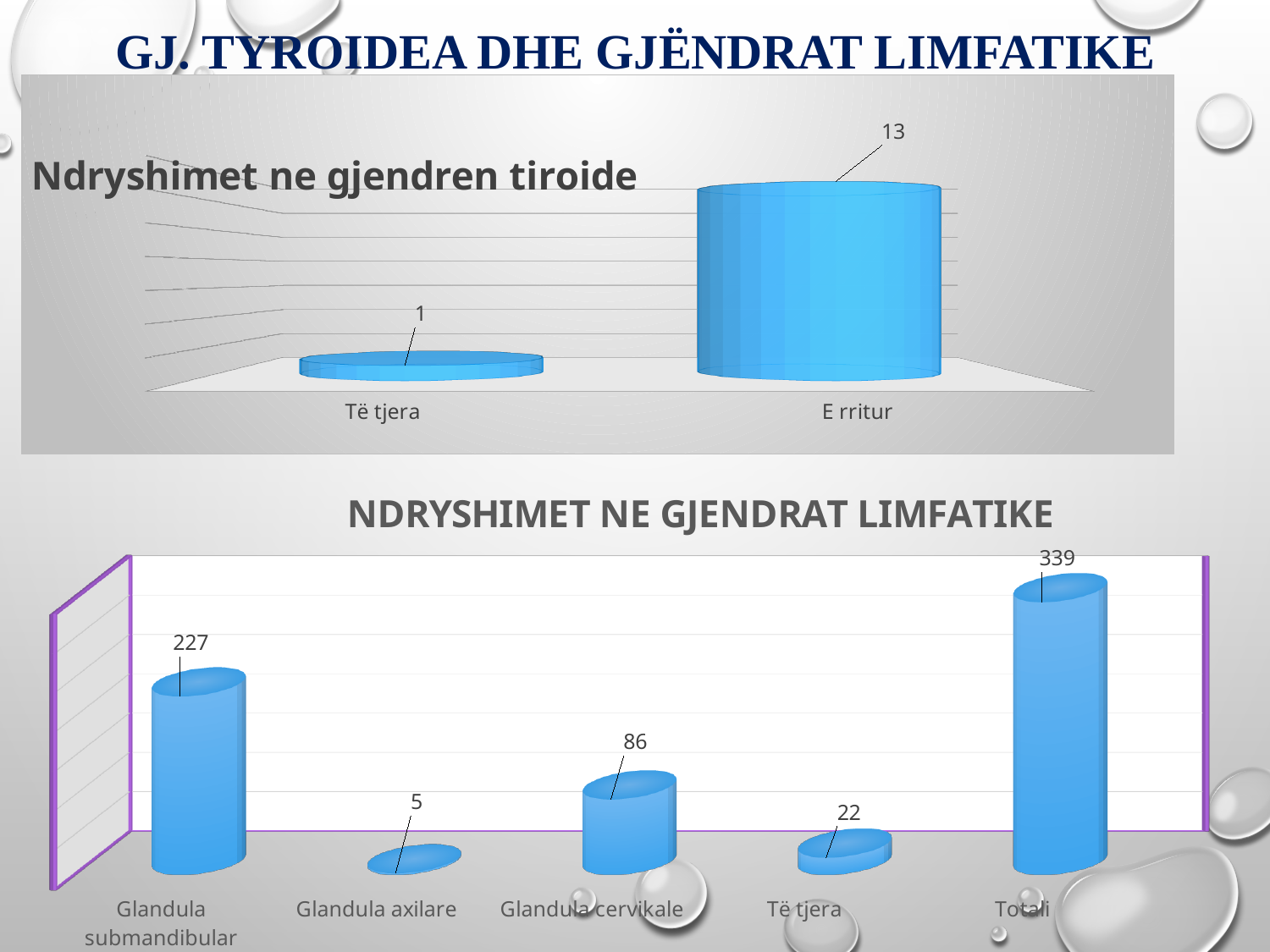
In the chart titled 'Ndryshimet ne gjendrat limfatike', what is the value for 'Glandula cervikale'? 86 In the chart titled 'Ndryshimet ne gjendrat limfatike', what is the value for 'Glandula submandibular'? 227 In the chart titled 'Ndryshimet ne gjendrat limfatike', which category has the highest value? Totali What kind of chart is the chart titled 'Ndryshimet ne gjendrat limfatike'? Bar chart In the chart titled 'Ndryshimet ne gjendrat limfatike', what is the value for 'Të tjera'? 22 In the chart titled 'Ndryshimet ne gjendren tiroide', what is the difference between 'E rritur' and 'Të tjera'? 12 In the chart titled 'Ndryshimet ne gjendren tiroide', what is the value for 'E rritur'? 13 In the chart titled 'Ndryshimet ne gjendren tiroide', what is the value for 'Të tjera'? 1 In the chart titled 'Ndryshimet ne gjendren tiroide', how many categories are shown? 2 In the chart titled 'Ndryshimet ne gjendrat limfatike', what is the difference between 'Glandula submandibular' and 'Glandula cervikale'? 141 In the chart titled 'Ndryshimet ne gjendrat limfatike', which is larger: 'Glandula cervikale' or 'Të tjera'? Glandula cervikale In the chart titled 'Ndryshimet ne gjendrat limfatike', which category has the lowest value? Glandula axilare